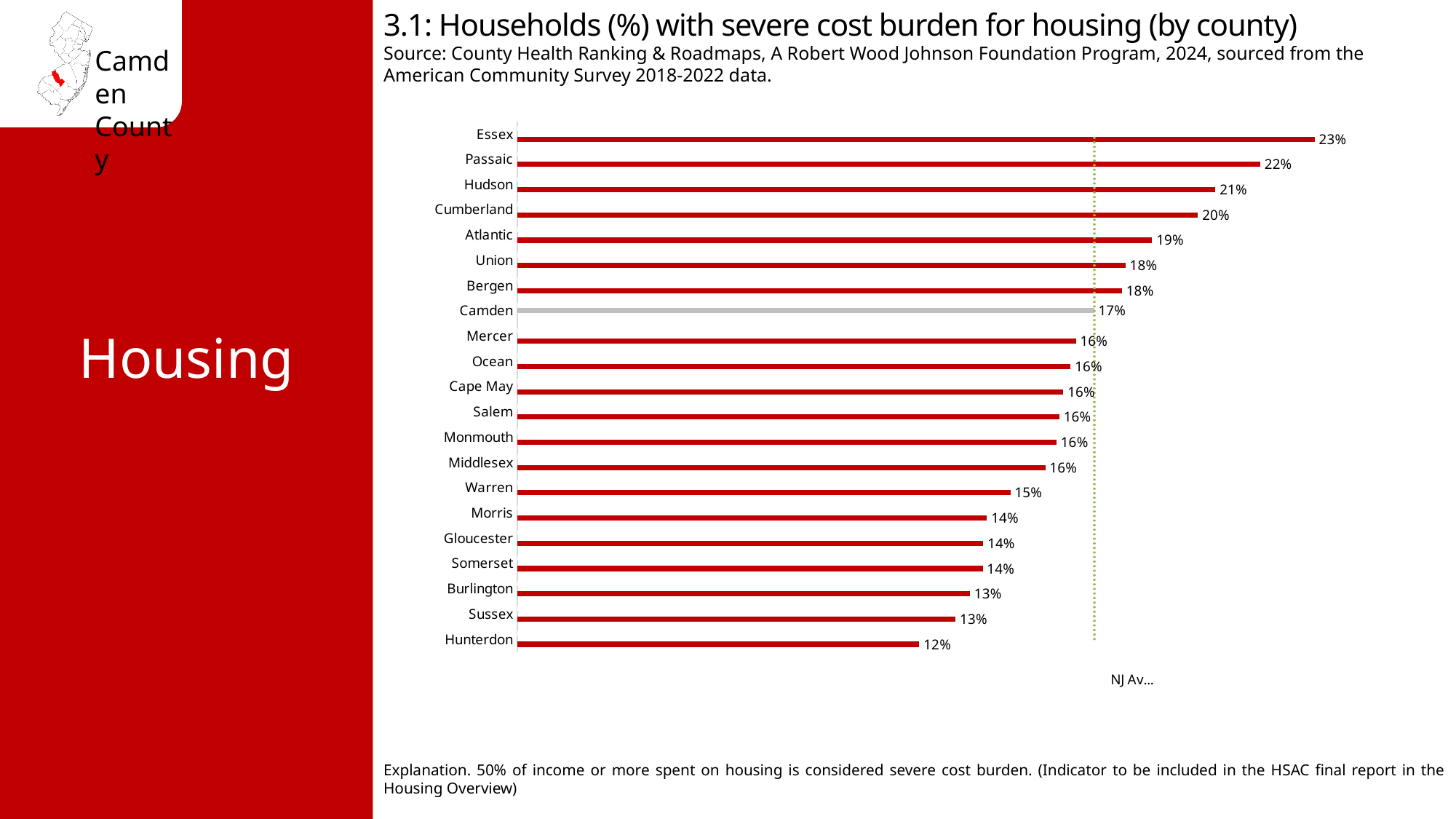
How many counties are shown in the chart? 21 What is the difference between the values for Passaic and Camden? 5% Which county has the lowest value? Hunterdon What is the value for Camden? 17% Which county has the highest value? Essex What kind of chart is this? Bar chart Which county's bar is shown in grey rather than red? Camden What is the value for Hunterdon? 12% What is the value for Atlantic? 19% Which is larger, the value for Hudson or the value for Warren? Hudson What is the difference between the values for Essex and Hunterdon? 11% What is the value for Essex? 23%